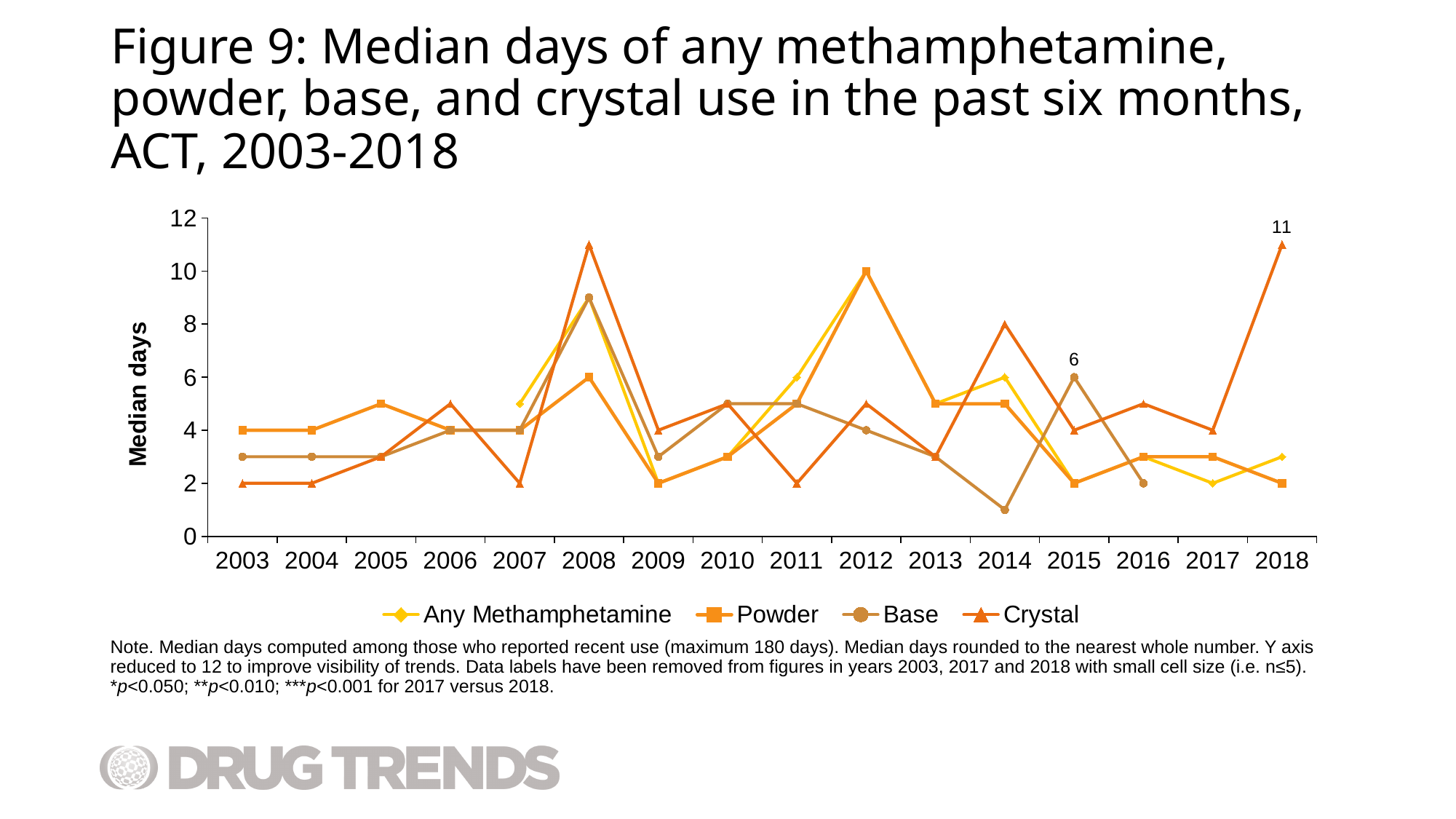
What is the value for Crystal in 2018? 11 What is the value for Crystal in 2014? 8 What is the value for Base in 2015? 6 What is the value for Powder in 2012? 10 What kind of chart is shown on the slide? Line chart How many series does the legend list? 4 In which year is the Base series lowest? 2014 Which is larger in 2012, the Powder value or the Crystal value? Powder Is the value for Crystal in 2008 greater or less than 10? greater In which year is the Crystal series highest? 2008 and 2018 How many years are shown on the x axis? 16 What is the difference between the Crystal value in 2018 and the Base value in 2015? 5